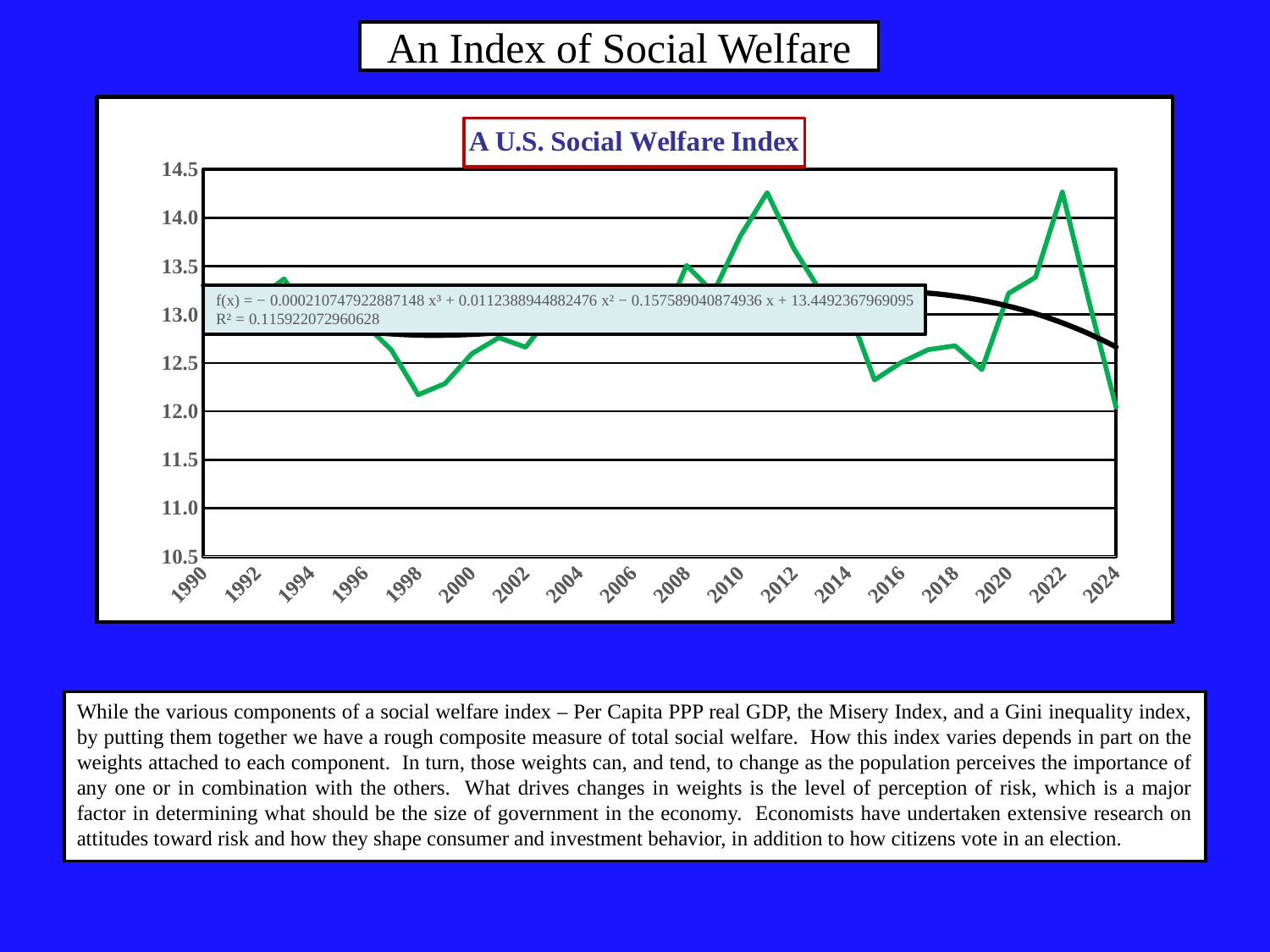
Does the index rise or fall between 2022 and 2024? fall Which year has the larger value, 2011 or 1998? 2011 What kind of chart is shown on the slide? line chart Is the value for 2024 greater or less than 12.5? less Which year has the larger value, 2022 or 2024? 2022 What is the title of the chart? A U.S. Social Welfare Index How many year labels are shown along the x axis? 18 What R² value is printed in the equation box on the chart? 0.115922072960628 Is the value for 2011 greater or less than 14.0? greater Is the value for 1998 greater or less than 12.5? less